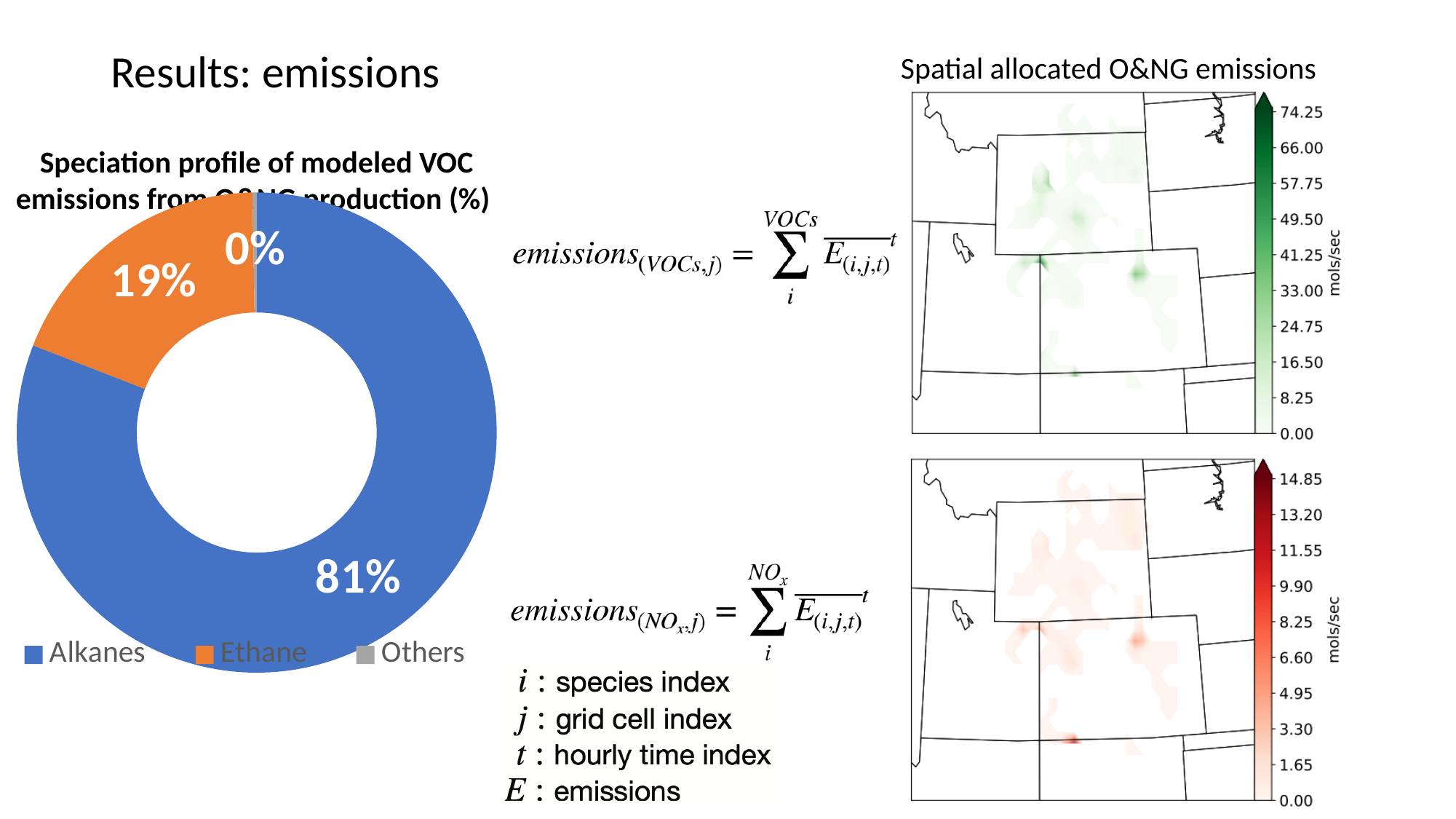
What is the title of the chart on the left of the slide? Speciation profile of modeled VOC emissions from O&NG production (%) In the speciation profile chart, what colour represents Ethane? orange In the speciation profile chart, what percentage is shown for Others? 0% In the speciation profile chart, which category has the largest share? Alkanes In the speciation profile chart, what percentage of modeled VOC emissions is Ethane? 19% In the speciation profile chart, which is larger, the share for Ethane or the share for Alkanes? Alkanes In the speciation profile chart, what is the combined share of Alkanes and Ethane? 100% How many categories does the speciation profile chart's legend list? 3 In the speciation profile chart, which category has the smallest share? Others What kind of chart is the speciation profile of modeled VOC emissions? doughnut chart In the speciation profile chart, what is the difference in percentage points between Alkanes and Ethane? 62 In the speciation profile chart, what percentage of modeled VOC emissions is Alkanes? 81%